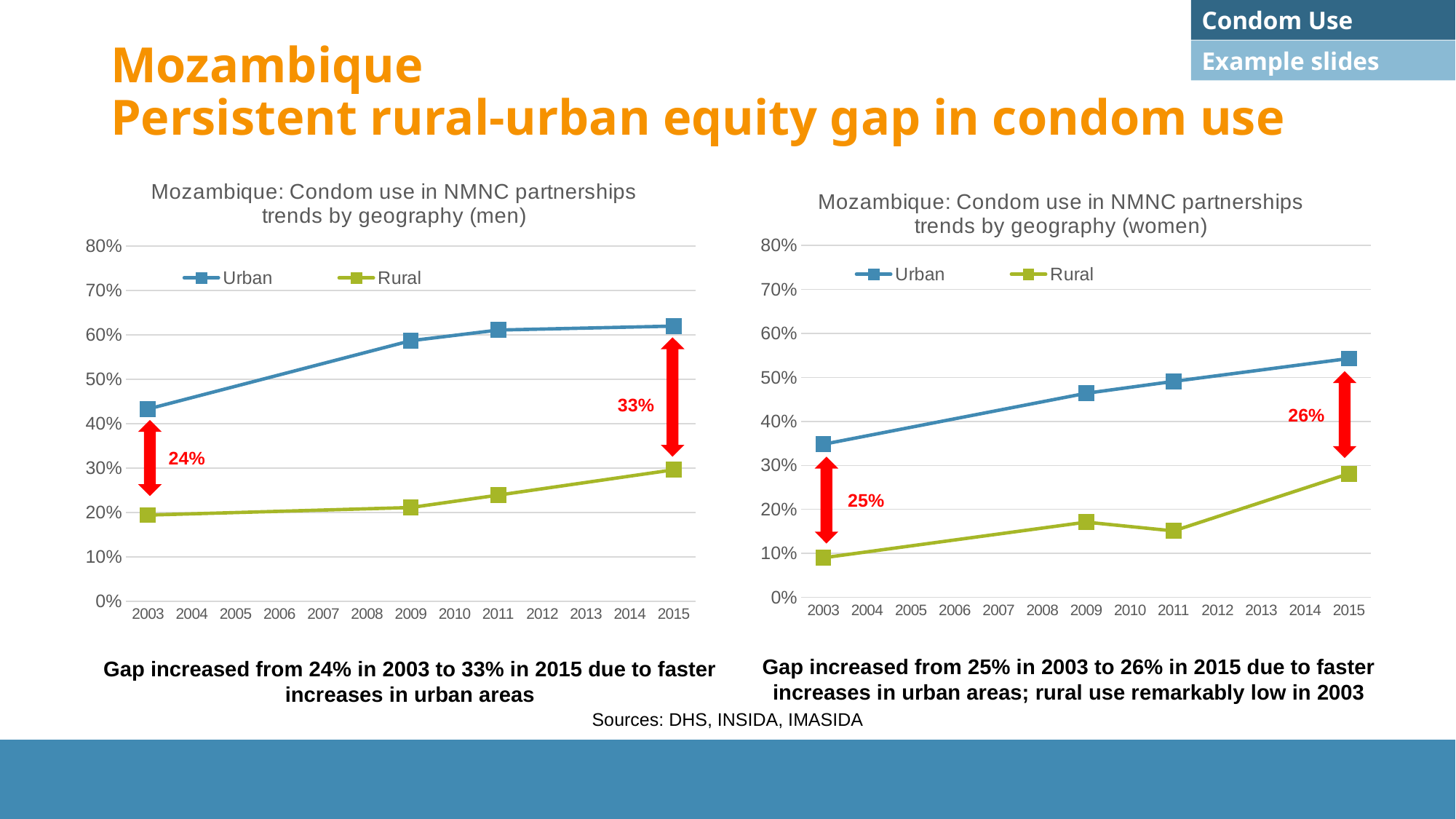
In the left chart (men), what is the labelled gap between Urban and Rural in 2015? 33% In the right chart (women), what is the labelled gap between Urban and Rural in 2015? 26% In the right chart (women), what is the labelled gap between Urban and Rural in 2003? 25% In the left chart (men), does the Urban series rise or fall from 2003 to 2015? rise In the right chart (women), which series is higher in 2015, Urban or Rural? Urban How many series does the legend list in the right chart (women)? 2 What kind of chart is the left chart, 'Mozambique: Condom use in NMNC partnerships trends by geography (men)'? line chart In the right chart (women), which year has the lowest Rural value? 2003 In the left chart (men), what is the labelled gap between Urban and Rural in 2003? 24% In the left chart (men), how many data points are plotted for the Rural series? 4 In the left chart (men), is the Urban value for 2015 greater or less than 60%? greater